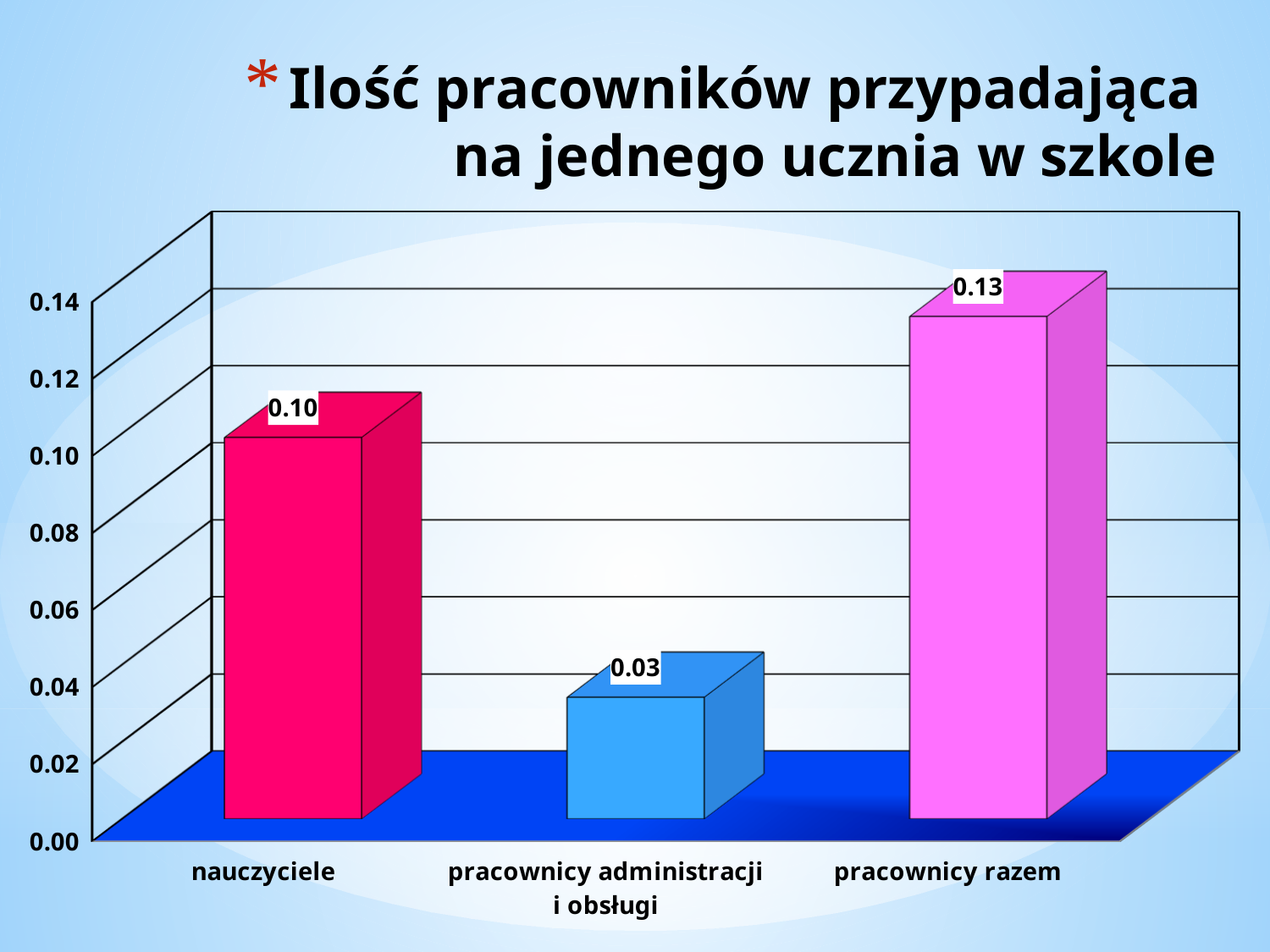
Which category has the lowest value? pracownicy administracji i obsługi What kind of chart is shown on the slide? bar chart What is the value for pracownicy administracji i obsługi? 0.03 What is the difference between the values for nauczyciele and pracownicy administracji i obsługi? 0.07 What is the title of the chart? Ilość pracowników przypadająca na jednego ucznia w szkole Which category has the highest value? pracownicy razem How many categories are shown in the chart? 3 Is the value for pracownicy razem greater or less than 0.12? greater What is the value for pracownicy razem? 0.13 What is the difference between the values for pracownicy razem and nauczyciele? 0.03 Which is larger, the value for nauczyciele or the value for pracownicy administracji i obsługi? nauczyciele What is the value for nauczyciele? 0.10